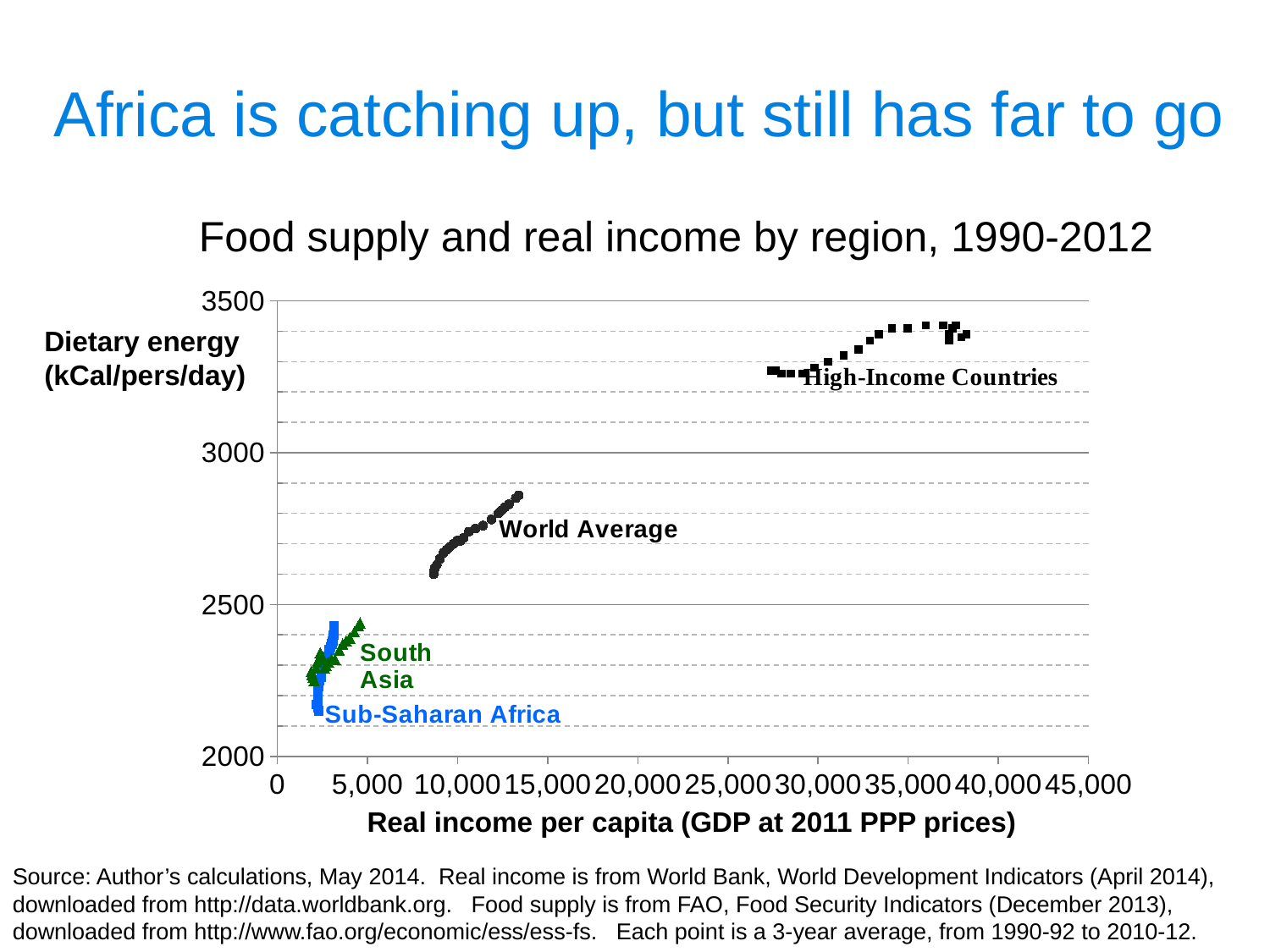
Which labelled series has the lowest dietary energy values? Sub-Saharan Africa Which has higher dietary energy values, the World Average or South Asia? World Average Which labelled series has the highest dietary energy values? High-Income Countries For the World Average series, does dietary energy rise or fall as real income per capita increases? rise Are the dietary energy values for the World Average greater or less than 2500 kCal/pers/day? greater Are the dietary energy values for High-Income Countries greater or less than 3000 kCal/pers/day? greater What is the title of the chart? Food supply and real income by region, 1990-2012 How many regional series are labelled on the chart? 4 What kind of chart is shown on the slide? scatter chart Are the real income values for the World Average greater or less than 20,000? less